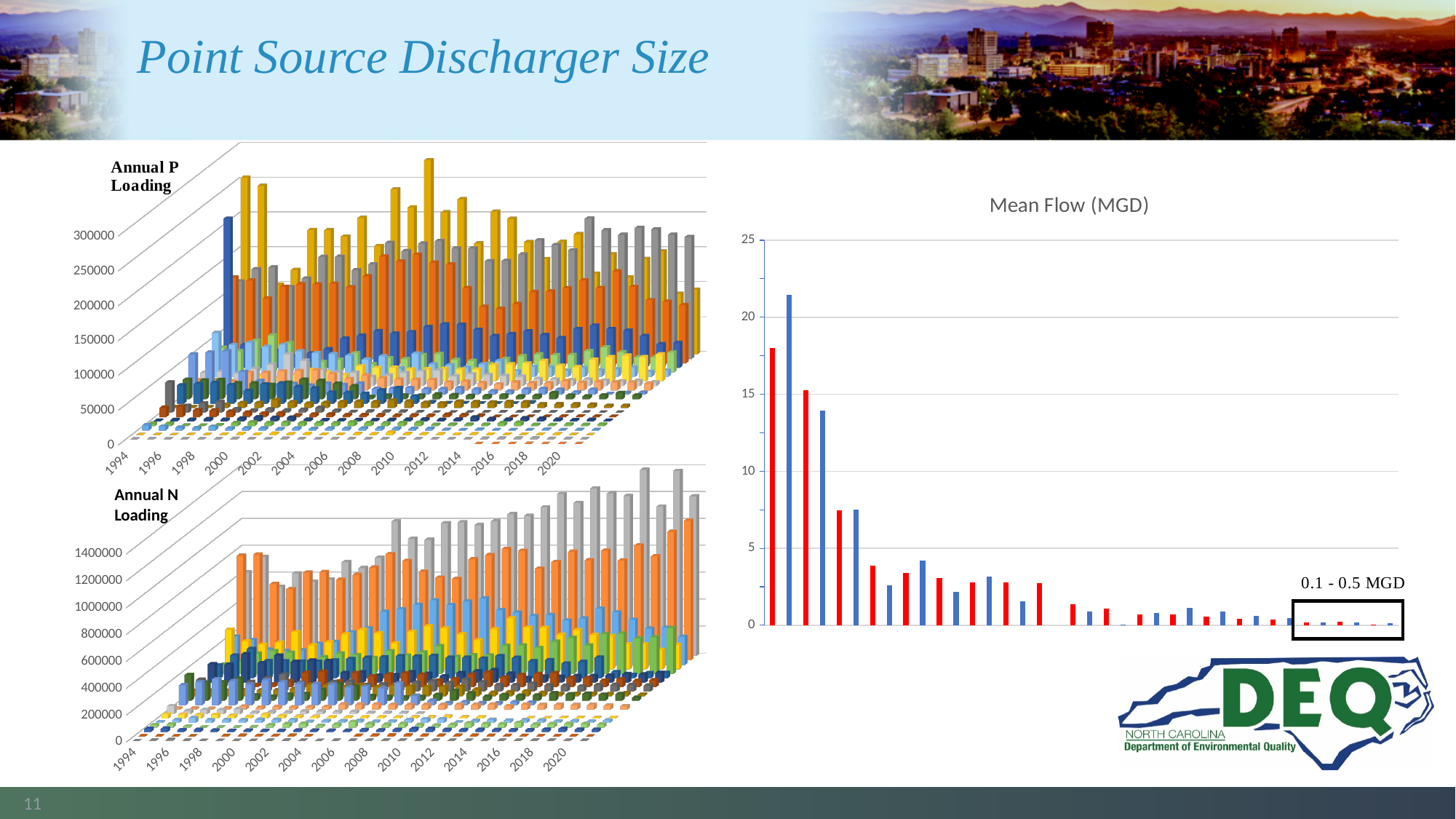
In the Mean Flow (MGD) chart, is the tallest bar greater or less than 20? greater In the Mean Flow (MGD) chart, is the leftmost bar greater or less than 15? greater In the Mean Flow (MGD) chart, do the bar values generally rise or fall from left to right? fall What kind of chart is the Mean Flow (MGD) chart? bar chart In the Mean Flow (MGD) chart, which is larger: the leftmost bar or the second bar from the left? the second bar from the left What is the title of the chart on the right side of the slide? Mean Flow (MGD) What text labels the boxed group of small bars at the right end of the Mean Flow (MGD) chart? 0.1 - 0.5 MGD What kind of chart is the Annual P Loading chart? bar chart In the Mean Flow (MGD) chart, is the leftmost bar greater or less than 20? less